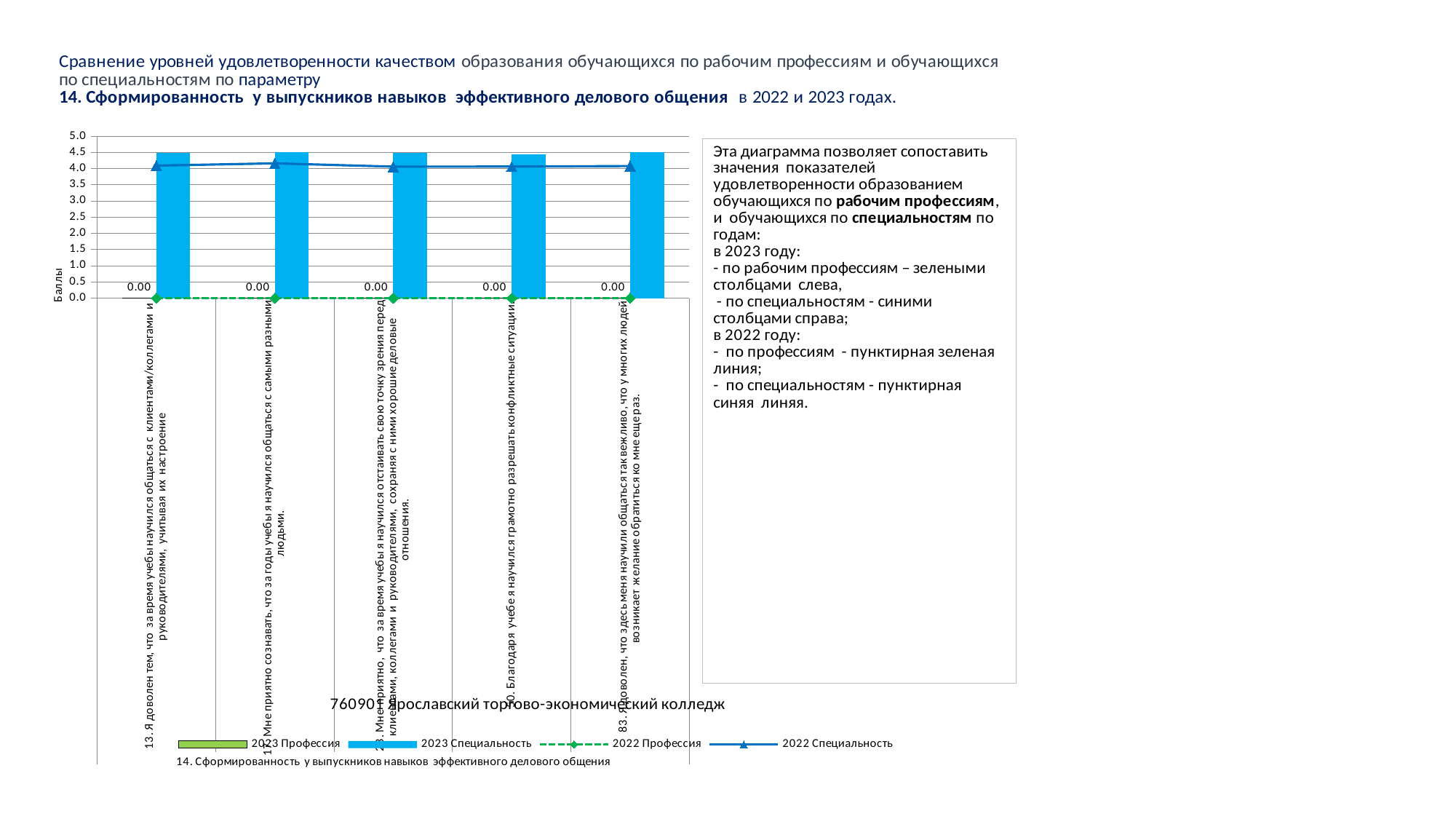
What is the value of the 2023 Профессия series for category 13 (Я доволен тем, что за время учебы научился общаться с клиентами/коллегами и руководителями)? 0.00 For category 83, which is larger: the 2023 Специальность value or the 2023 Профессия value? 2023 Специальность What is the label of the vertical axis of the chart? Баллы How many series does the chart legend list? 4 Is the value of the 2022 Специальность series for category 83 greater or less than 3.5? greater Do the values of the 2023 Профессия series rise, fall or stay flat across the categories? stay flat Is the value of the 2023 Специальность series for category 13 greater or less than 4.0? greater How many categories are plotted along the x axis of the chart? 5 What kind of chart is shown on the slide? bar chart (with line series) Is the value of the 2023 Специальность series for category 50 greater or less than 3.0? greater What colour are the bars for the 2023 Специальность series? blue What is the value of the 2023 Профессия series for category 50 (Благодаря учебе я научился грамотно разрешать конфликтные ситуации)? 0.00